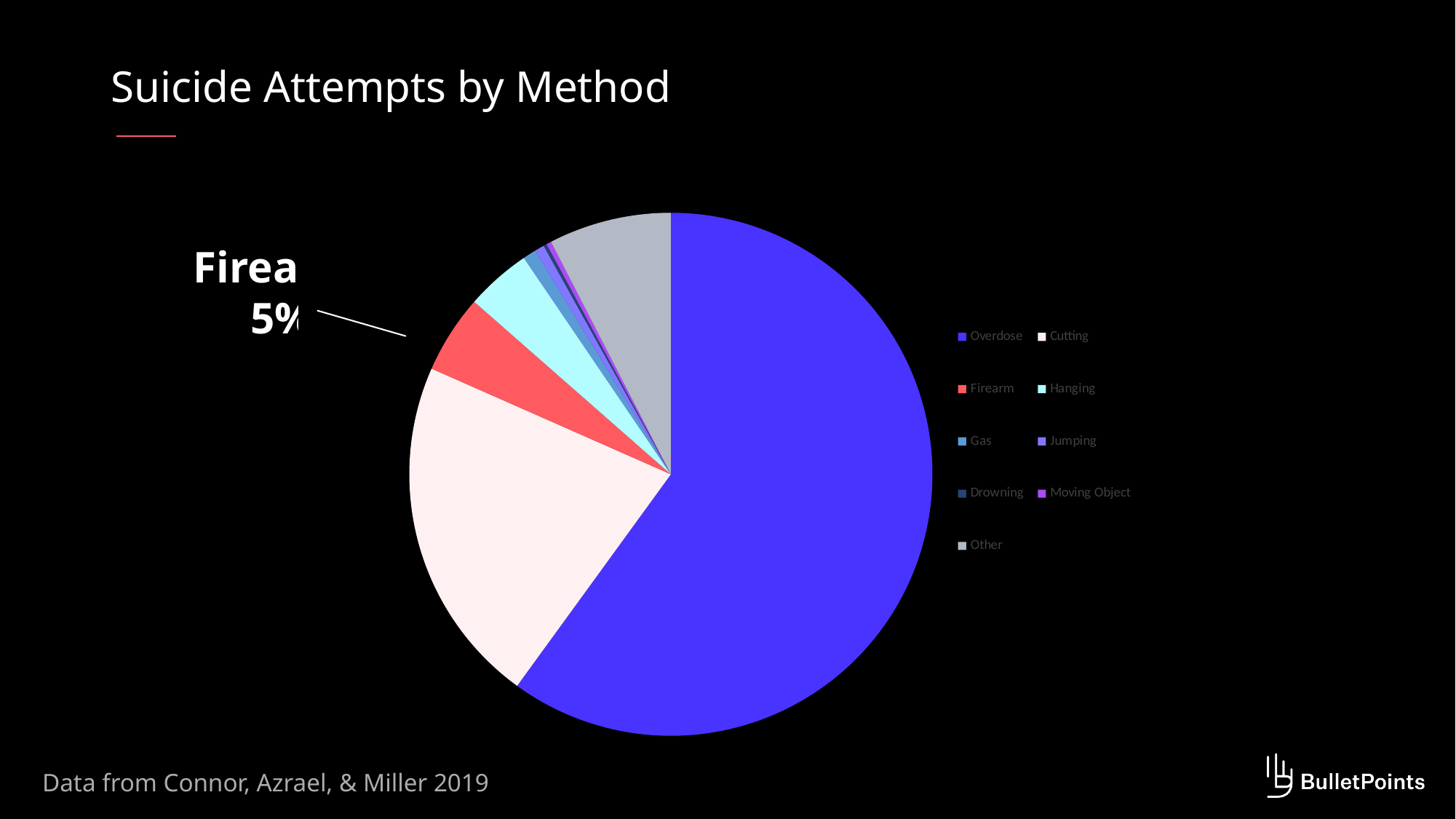
Does the Overdose slice account for more or less than half of the pie? more Which slice is larger, Overdose or Cutting? Overdose What share of the pie is labelled for Firearm? 5% Which slice is larger, Cutting or Firearm? Cutting What kind of chart is shown on the slide? Pie chart Which slice is larger, Firearm or Hanging? Firearm According to the footnote, what is the source of the data? Connor, Azrael, & Miller 2019 Which method has the second-largest slice of the pie? Cutting What is the title of the chart? Suicide Attempts by Method How many methods (categories) does the legend list? 9 Which method has the largest slice of the pie? Overdose